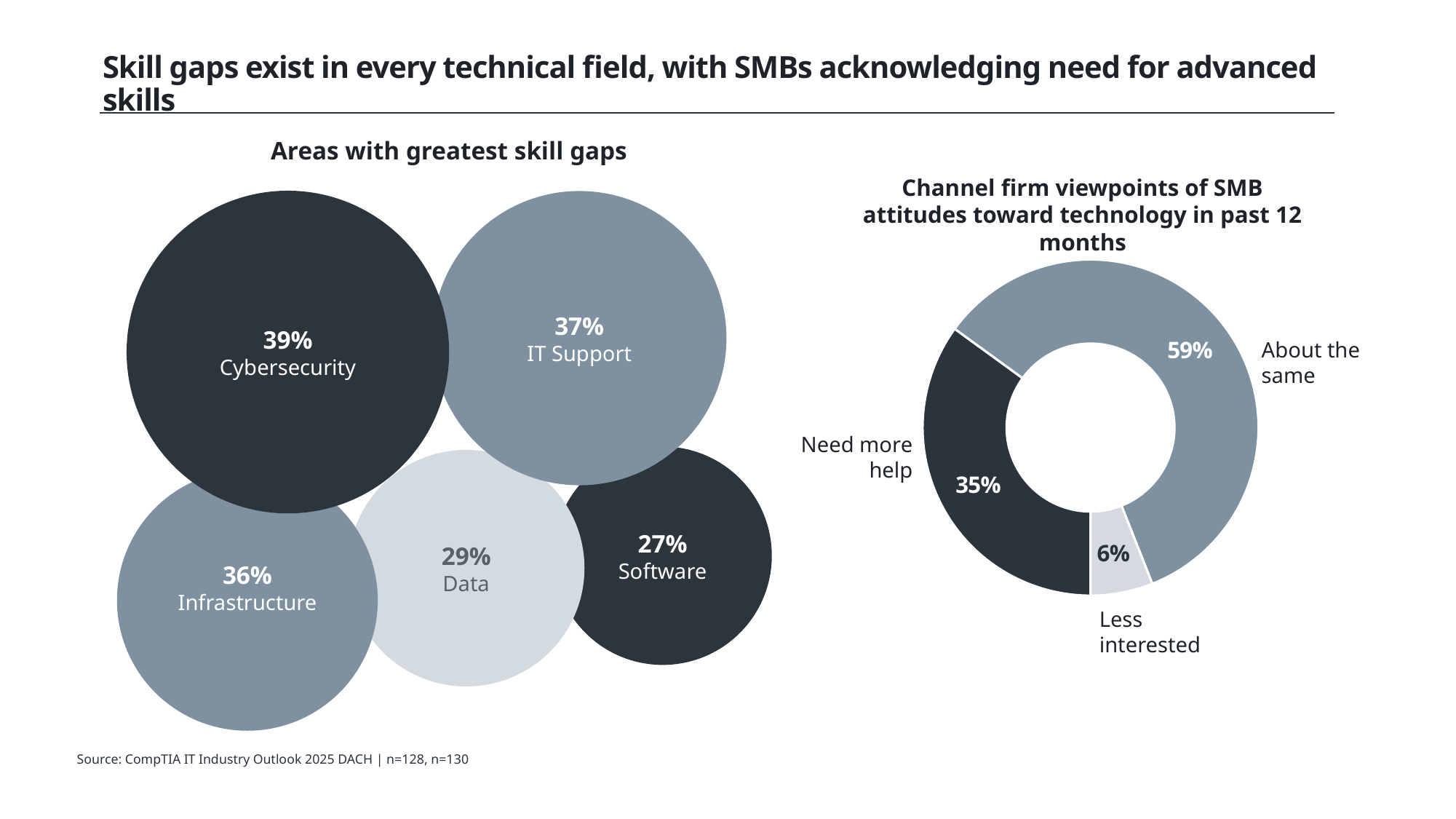
In the 'Channel firm viewpoints of SMB attitudes toward technology in past 12 months' chart, what share is 'Less interested'? 6% In the 'Channel firm viewpoints of SMB attitudes toward technology in past 12 months' chart, what share is 'About the same'? 59% In the 'Areas with greatest skill gaps' chart, what percentage is shown for Cybersecurity? 39% In the 'Areas with greatest skill gaps' chart, how many areas are shown? 5 What kind of chart is the 'Channel firm viewpoints of SMB attitudes toward technology in past 12 months' chart? Doughnut chart In the 'Areas with greatest skill gaps' chart, what percentage is shown for Data? 29% In the 'Areas with greatest skill gaps' chart, which is larger: Infrastructure or Data? Infrastructure In the 'Channel firm viewpoints of SMB attitudes toward technology in past 12 months' chart, what is the difference between 'About the same' and 'Need more help'? 24% In the 'Areas with greatest skill gaps' chart, what is the difference between the percentages for IT Support and Software? 10% In the 'Areas with greatest skill gaps' chart, which area has the lowest percentage? Software In the 'Channel firm viewpoints of SMB attitudes toward technology in past 12 months' chart, which category has the smallest share? Less interested In the 'Areas with greatest skill gaps' chart, which area has the highest percentage? Cybersecurity